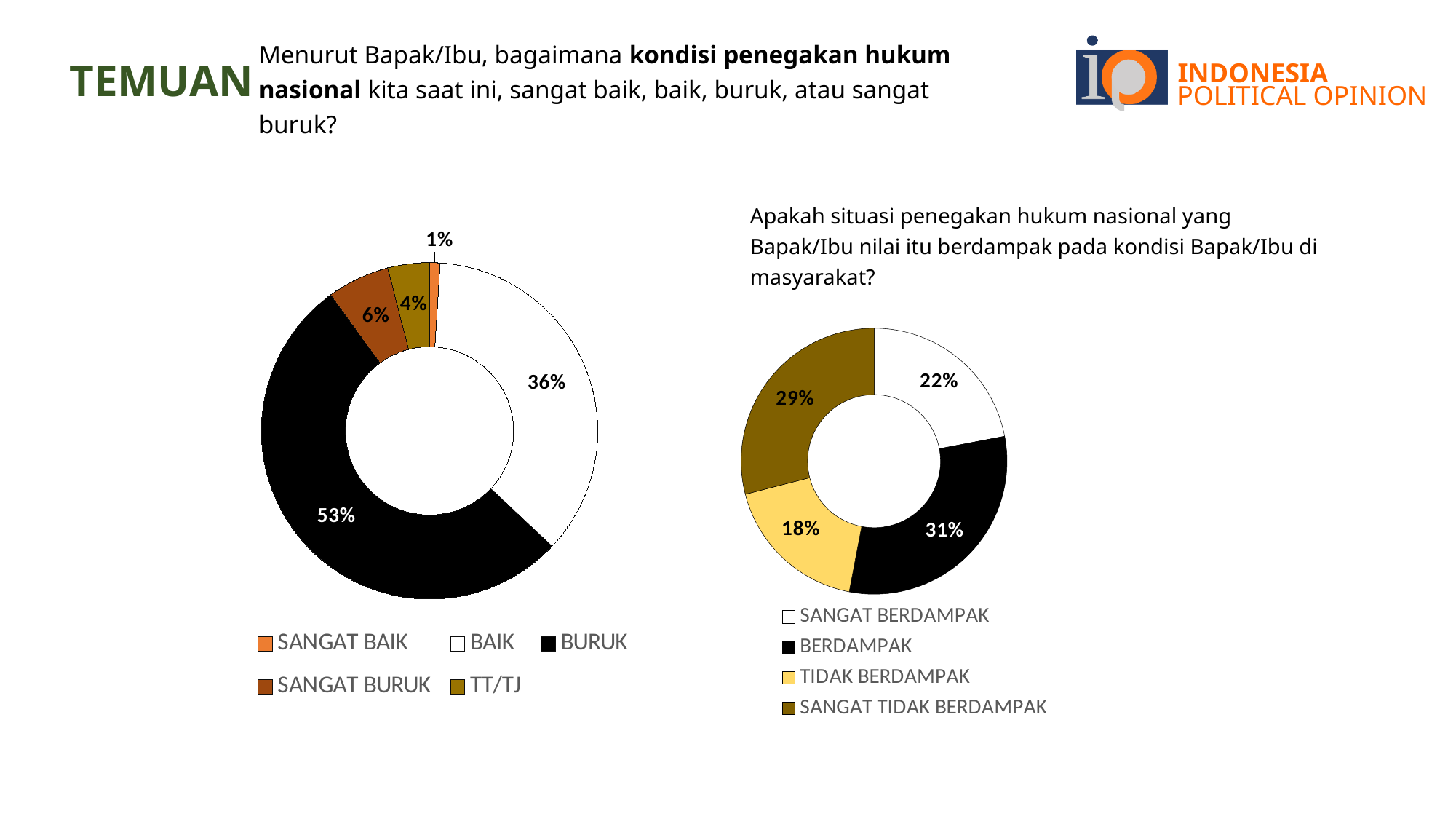
In the left chart, what percentage of respondents answered BURUK? 53% What type of chart is used on the right side of the slide? Donut (pie) chart In the left chart, which category has the largest share? BURUK In the left chart, how many categories does the legend list? 5 In the right chart, what percentage of respondents answered SANGAT TIDAK BERDAMPAK? 29% In the left chart, what is the difference between the BURUK and BAIK shares? 17% In the left chart, what percentage of respondents answered BAIK? 36% In the right chart, which category has the smallest share? TIDAK BERDAMPAK In the right chart, which is larger, SANGAT BERDAMPAK or TIDAK BERDAMPAK? SANGAT BERDAMPAK In the right chart, what percentage of respondents answered BERDAMPAK? 31% In the right chart, what is the difference between the BERDAMPAK and SANGAT BERDAMPAK shares? 9% In the left chart, which category has the smallest share? SANGAT BAIK